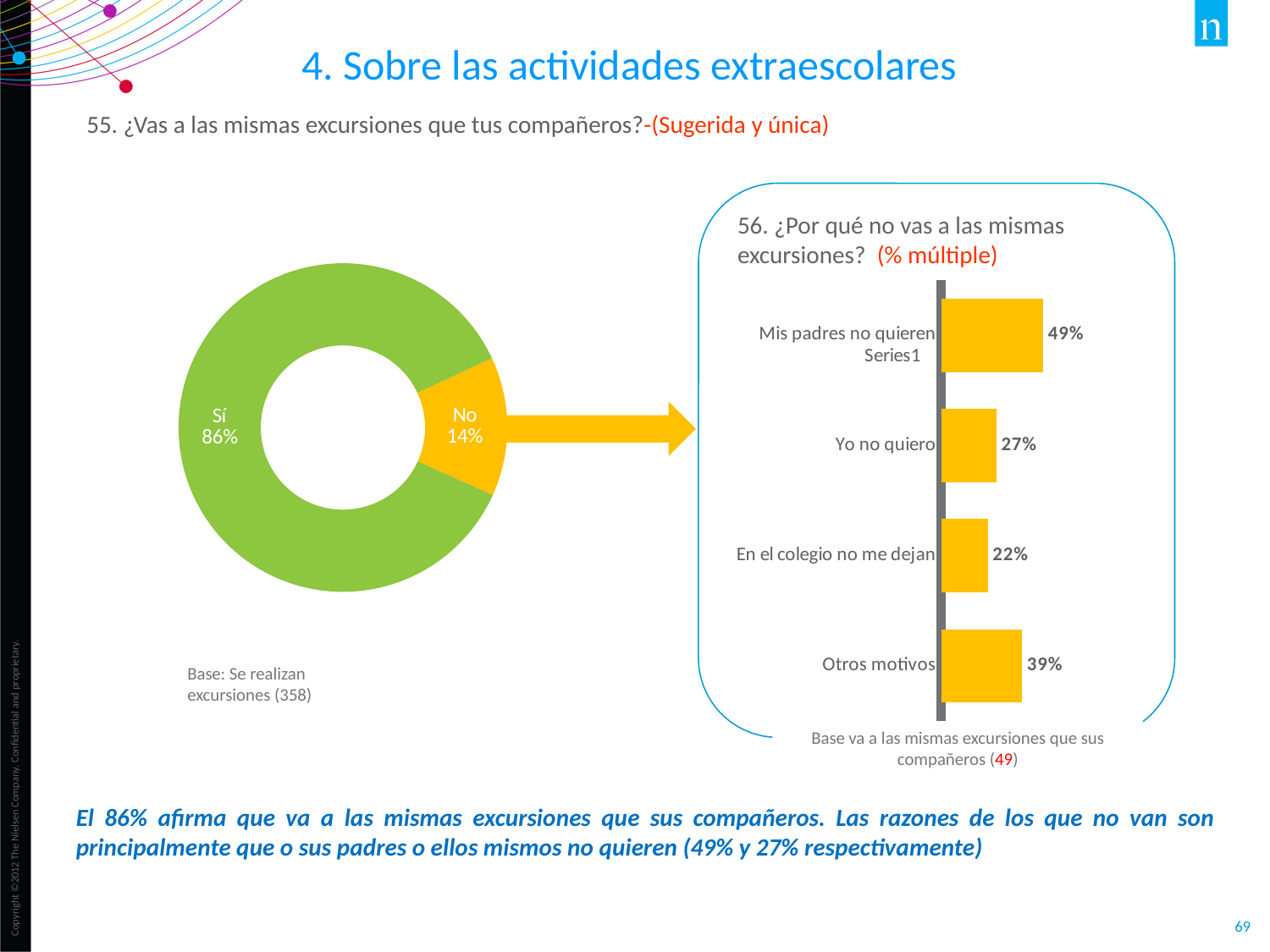
In the bar chart on the right (question 56), which category has the highest value? Mis padres no quieren In the donut chart on the left, what is the difference between the "Sí" and "No" shares? 72% In the donut chart on the left, how many slices are there? 2 In the bar chart on the right (question 56), how many categories are shown? 4 In the donut chart on the left, what percentage answered "Sí"? 86% In the bar chart on the right (question 56), which category has the lowest value? En el colegio no me dejan In the bar chart on the right (question 56), what is the value for "En el colegio no me dejan"? 22% In the bar chart on the right (question 56), what is the value for "Mis padres no quieren"? 49% In the donut chart on the left, what percentage answered "No"? 14% In the bar chart on the right (question 56), what is the difference between "Mis padres no quieren" and "Yo no quiero"? 22% In the bar chart on the right (question 56), which is larger: "Yo no quiero" or "Otros motivos"? Otros motivos What kind of chart is the chart on the left of the slide? Donut (pie) chart